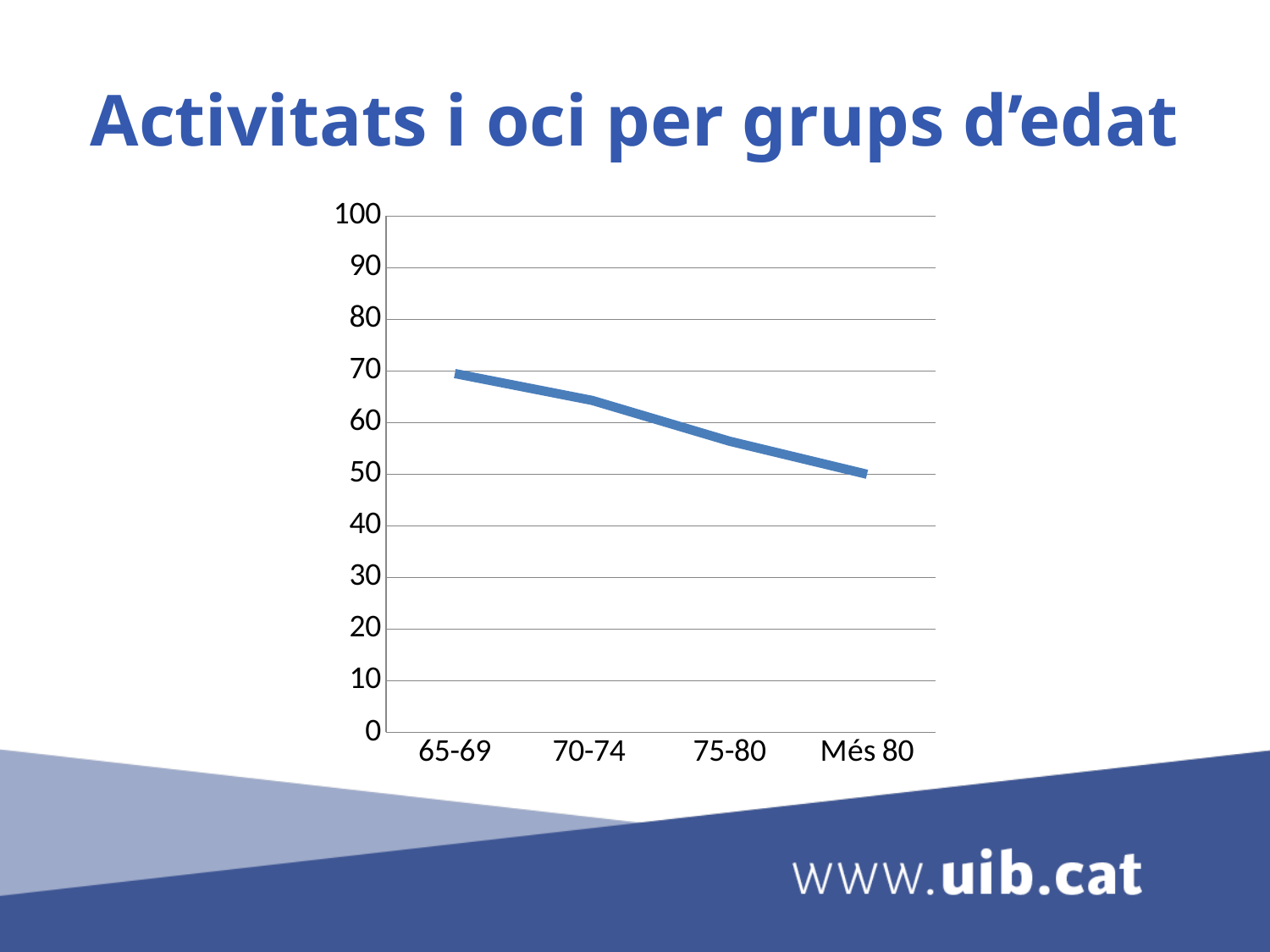
Do the values rise or fall from 65-69 to Més 80? fall Which age group has the lowest value? Més 80 Is the value for 65-69 greater or less than 60? greater Which age group has the highest value? 65-69 Is the value for 75-80 greater or less than 50? greater Is the value for 65-69 greater or less than 80? less What kind of chart is shown on the slide? line chart How many age groups are plotted along the x axis? 4 Which has the larger value, 65-69 or Més 80? 65-69 What is the title of the chart on the slide? Activitats i oci per grups d'edat